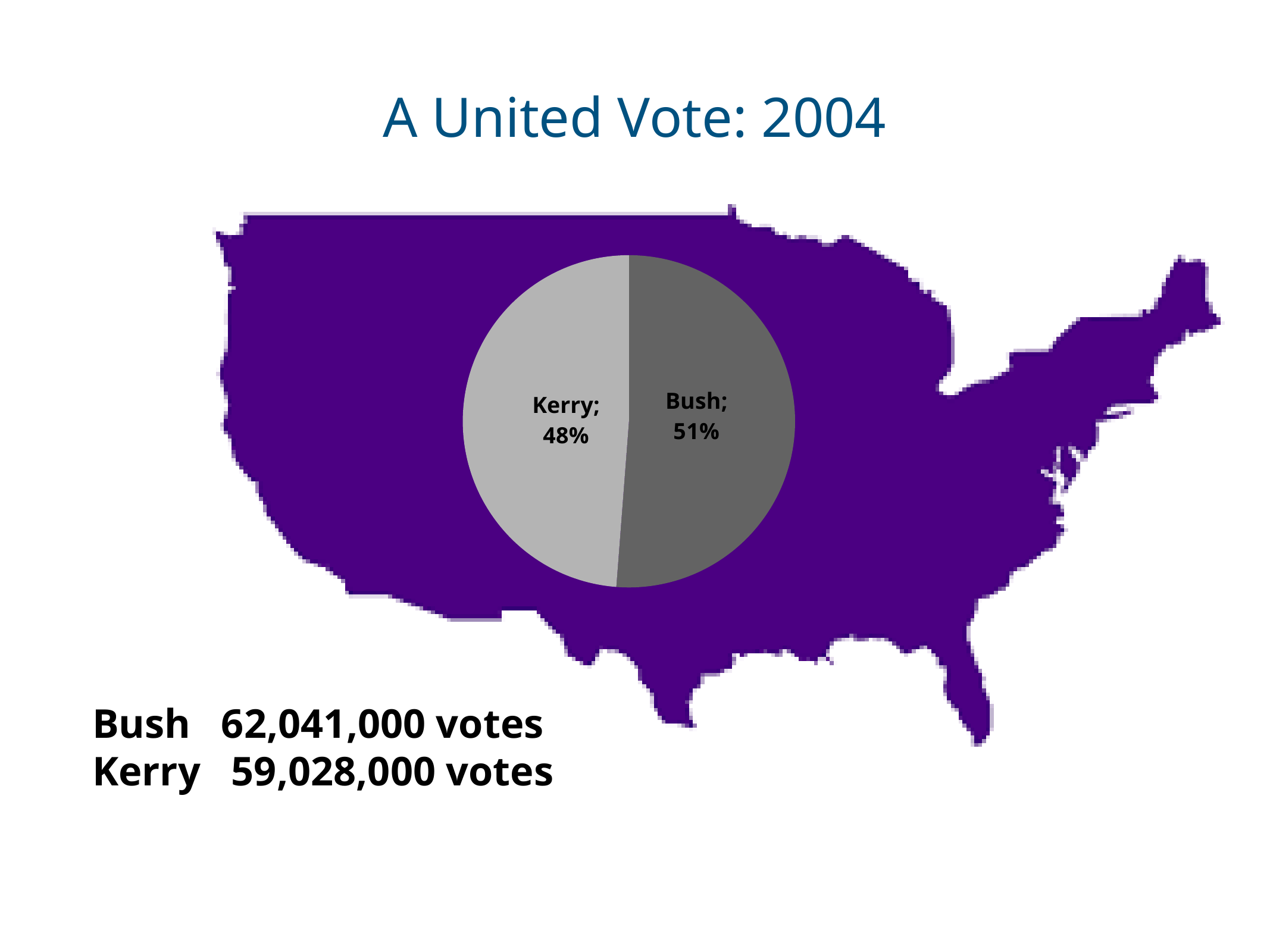
What kind of chart is shown on the slide? pie chart Which slice of the pie is shaded darker grey? Bush What share of the pie does Kerry have? 48% Which slice of the pie is the largest? Bush Is the value for Bush greater or less than 50%? greater Which is larger, the Bush slice or the Kerry slice? Bush Which slice of the pie is the smallest? Kerry What is the title of the slide containing the pie chart? A United Vote: 2004 What is the difference in percentage points between the Bush slice and the Kerry slice? 3% How many slices does the pie chart have? 2 What share of the pie does Bush have? 51% Is the value for Kerry greater or less than 50%? less